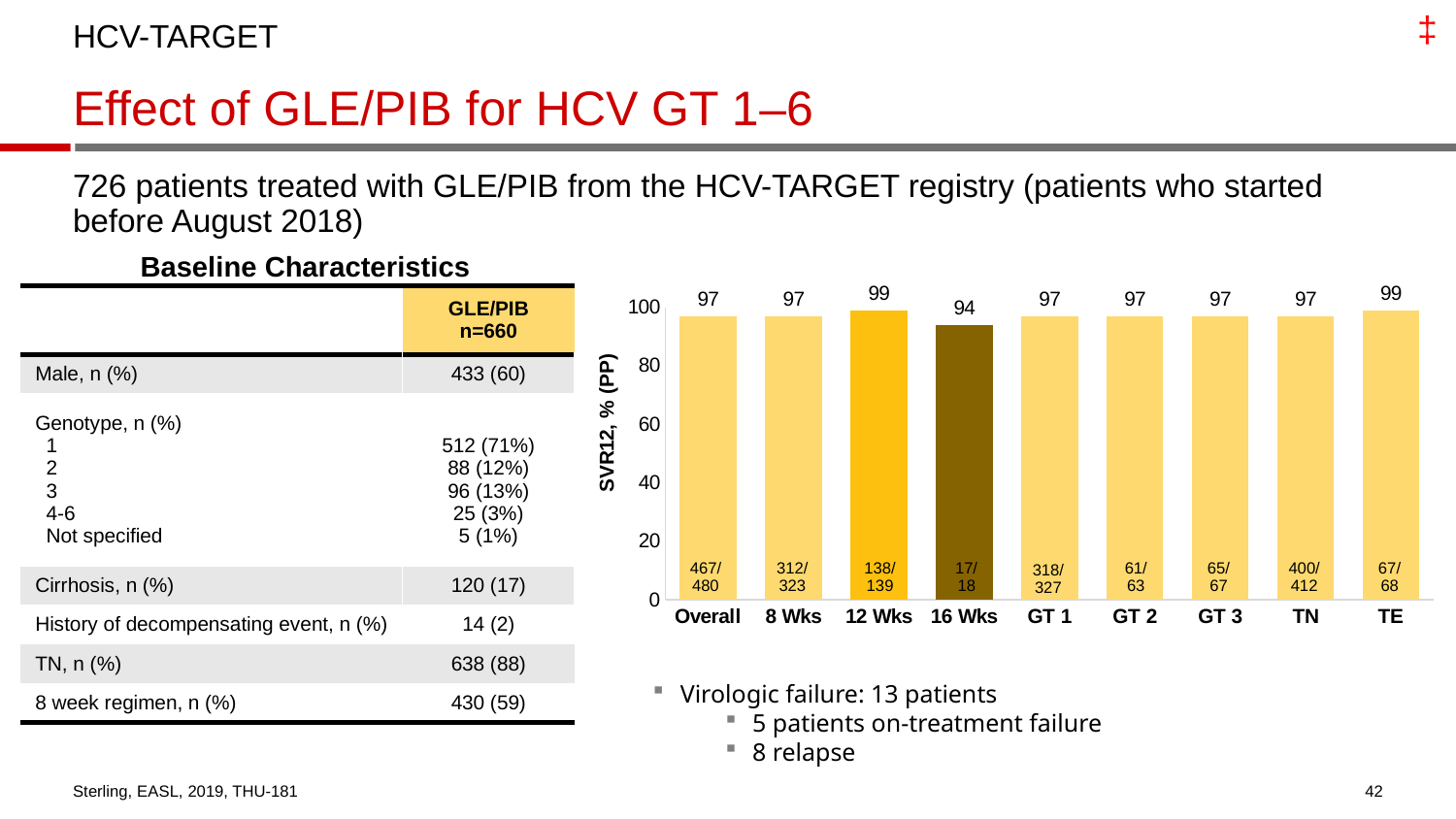
What is the SVR12 value for the 16 Wks bar? 94 What fraction of patients is shown inside the 16 Wks bar? 17/18 What kind of chart is shown on the slide? bar chart What is the difference between the SVR12 values for Overall and 16 Wks? 3 What is the difference between the SVR12 values for 12 Wks and 16 Wks? 5 Which has a higher SVR12 value, 16 Wks or GT 1? GT 1 What is the SVR12 value for the Overall bar? 97 Which category has the lowest SVR12 value? 16 Wks What is the SVR12 value for the 12 Wks bar? 99 How many categories are shown on the x axis of the chart? 9 What is the label of the y axis of the chart? SVR12, % (PP) What is the SVR12 value for the TE bar? 99